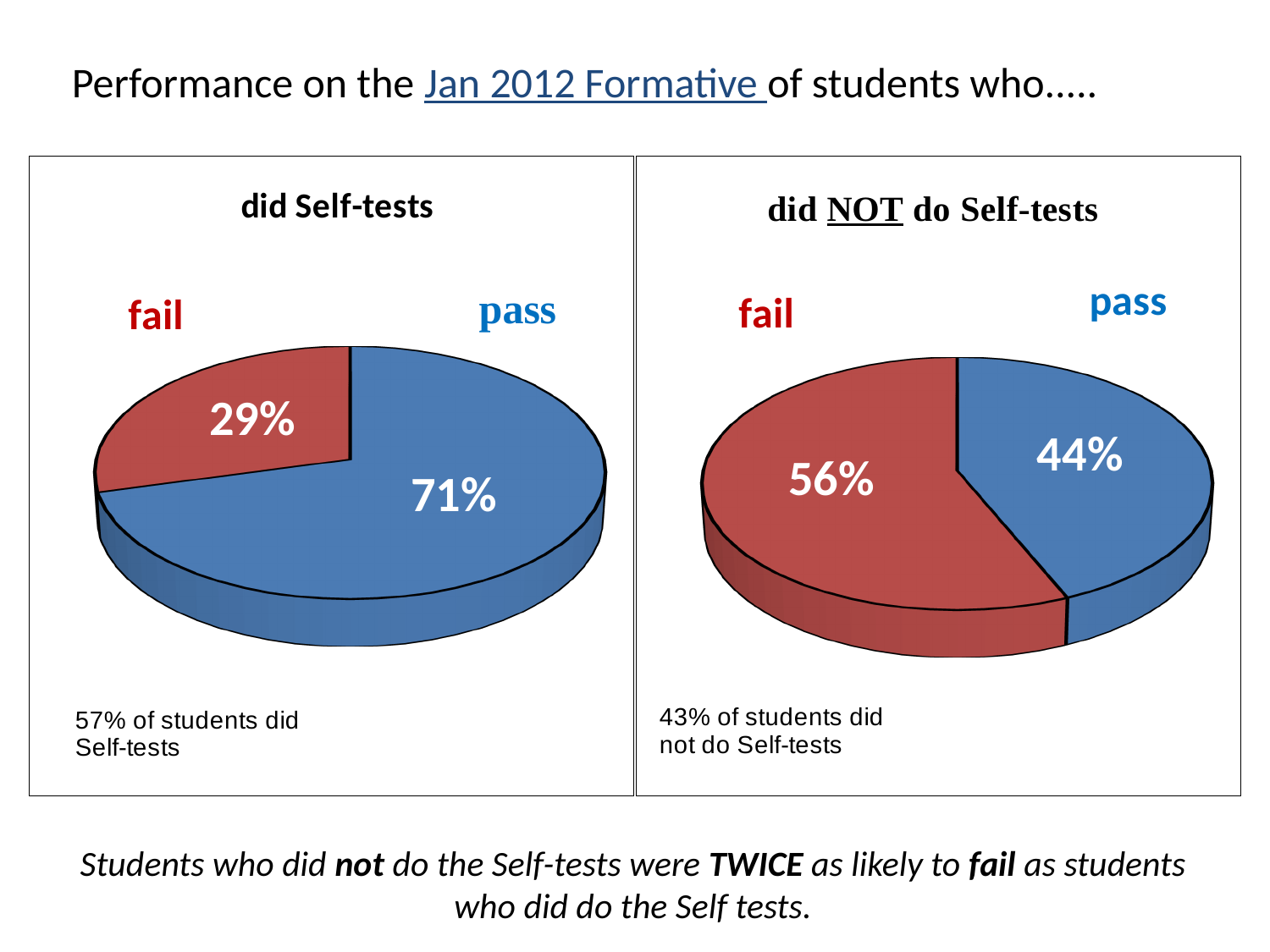
How many slices does the 'did NOT do Self-tests' pie chart have? 2 In the 'did NOT do Self-tests' chart, which slice is the largest? fail In the 'did Self-tests' chart, what percentage of students passed? 71% What type of chart is used in the 'did Self-tests' panel? pie chart In the 'did Self-tests' chart, what percentage of students failed? 29% In the 'did Self-tests' chart, what is the difference between the pass and fail percentages? 42% In the 'did Self-tests' chart, what colour is the fail slice? red Is the fail percentage higher in the 'did Self-tests' chart or the 'did NOT do Self-tests' chart? did NOT do Self-tests In the 'did NOT do Self-tests' chart, what is the difference between the fail and pass percentages? 12% In the 'did NOT do Self-tests' chart, what percentage of students failed? 56% In the 'did Self-tests' chart, which slice is larger, pass or fail? pass In the 'did NOT do Self-tests' chart, what percentage of students passed? 44%